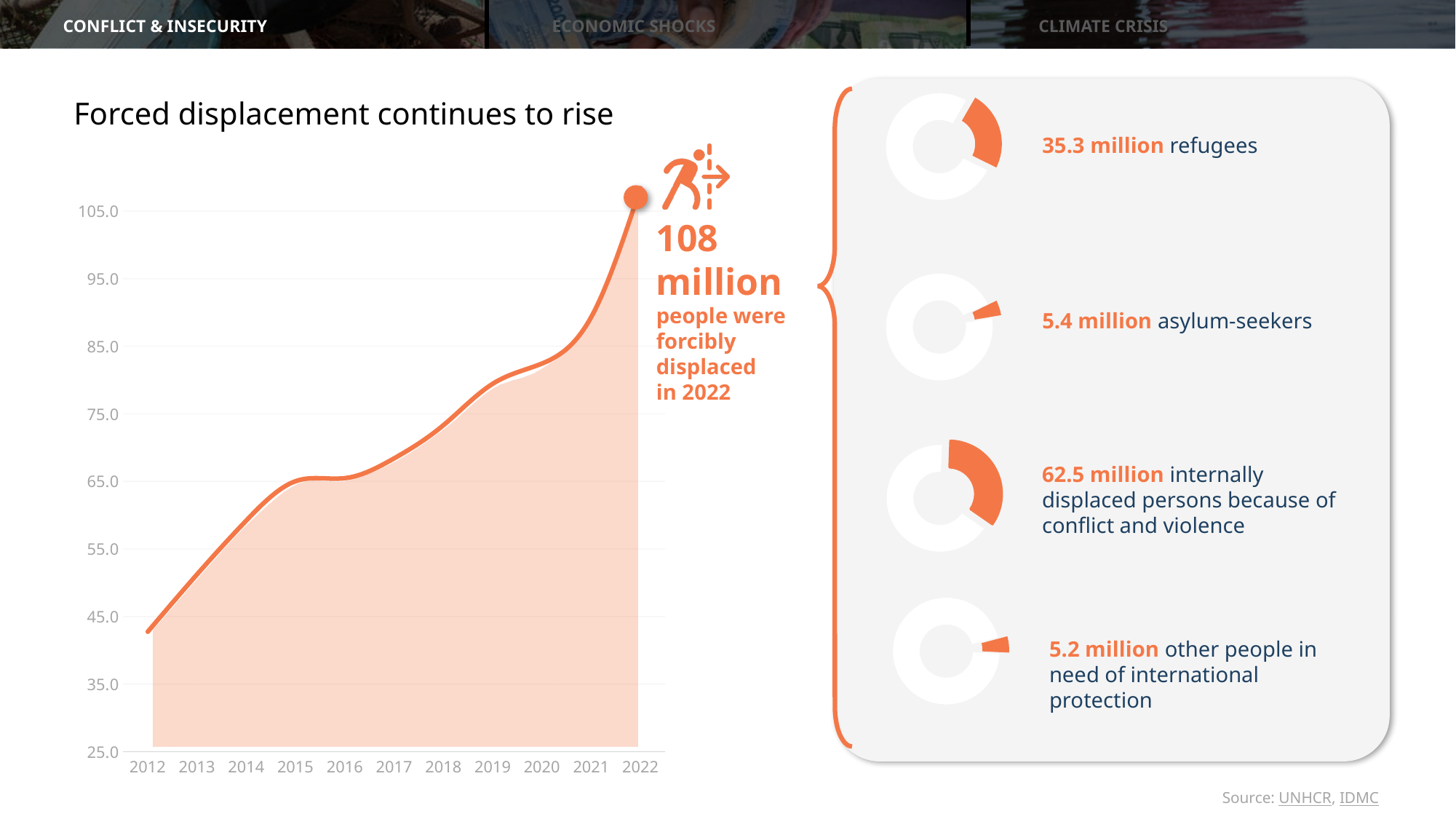
In the chart on the left, do the values rise or fall from 2012 to 2022? rise In the chart on the left, how many years are shown on the x axis? 11 In the chart on the left, is the value for 2015 greater or less than 55.0? greater In the chart on the left, which year has the lowest value? 2012 In the chart on the left, how many people were forcibly displaced in 2022? 108 million In the donut charts on the right, how many refugees are shown? 35.3 million What kind of chart is the chart on the left showing displacement from 2012 to 2022? area chart In the donut charts on the right, what is the difference between the number of internally displaced persons and the number of refugees? 27.2 million In the donut charts on the right, which group is larger: refugees or internally displaced persons because of conflict and violence? internally displaced persons because of conflict and violence In the chart on the left, which year has the highest value? 2022 In the chart on the left, is the value for 2021 greater or less than 95.0? less What is the title of the chart on the left of the slide? Forced displacement continues to rise